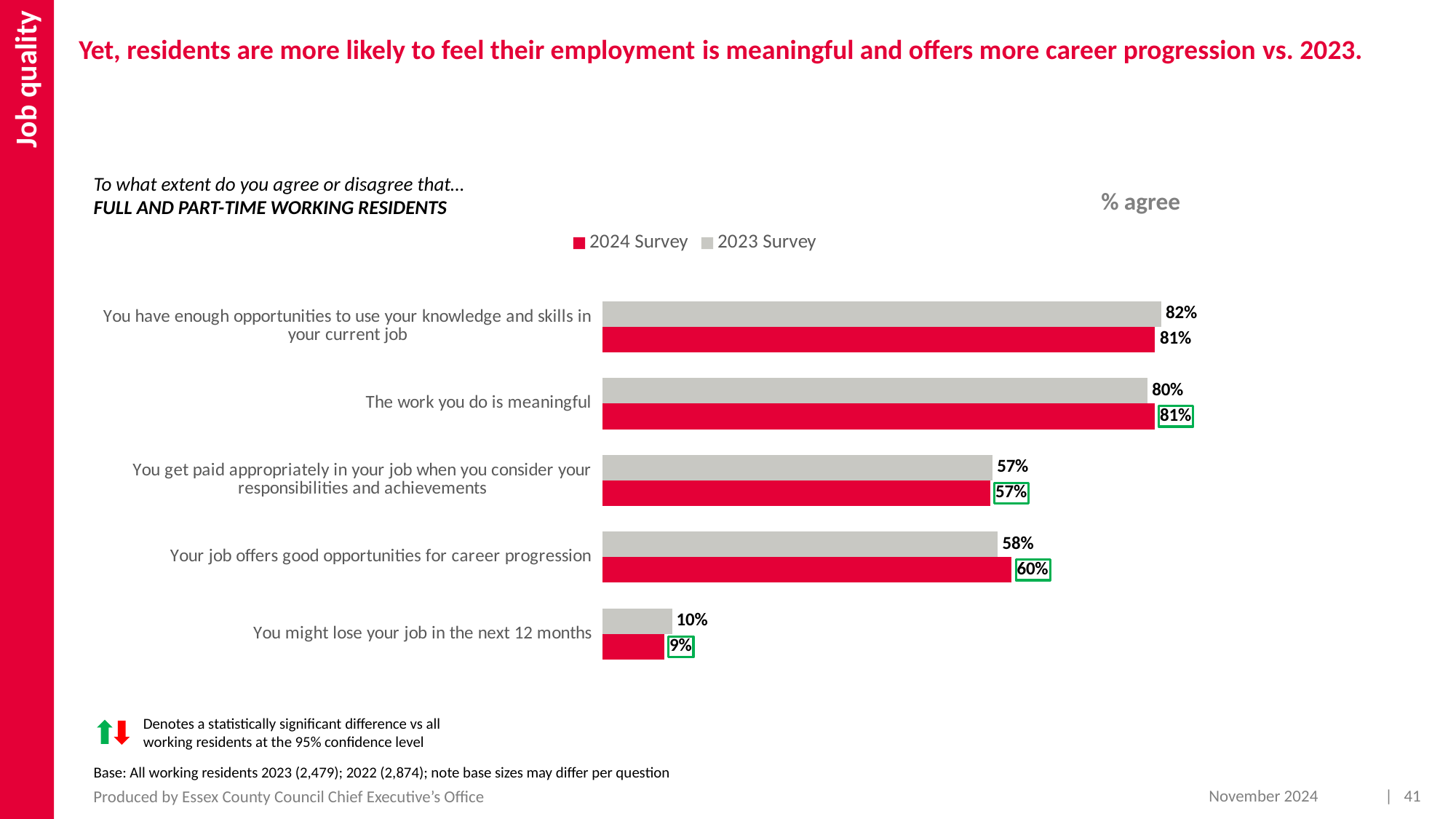
What kind of chart is shown on the slide? Bar chart Which statement has the lowest 2024 Survey value? You might lose your job in the next 12 months What is the 2024 Survey value for 'The work you do is meaningful'? 81% For 'You get paid appropriately in your job when you consider your responsibilities and achievements', is the 2024 Survey value higher, lower, or the same as the 2023 Survey value? The same Which statement has the highest 2023 Survey value? You have enough opportunities to use your knowledge and skills in your current job What is the 2024 Survey value for 'You might lose your job in the next 12 months'? 9% Which colour represents the 2024 Survey series in the chart? Red What is the 2023 Survey value for 'You have enough opportunities to use your knowledge and skills in your current job'? 82% How many statements (categories) are shown in the chart? 5 How many series does the legend list? 2 What is the 2023 Survey value for 'Your job offers good opportunities for career progression'? 58% What is the difference between the 2024 Survey and 2023 Survey values for 'Your job offers good opportunities for career progression'? 2%